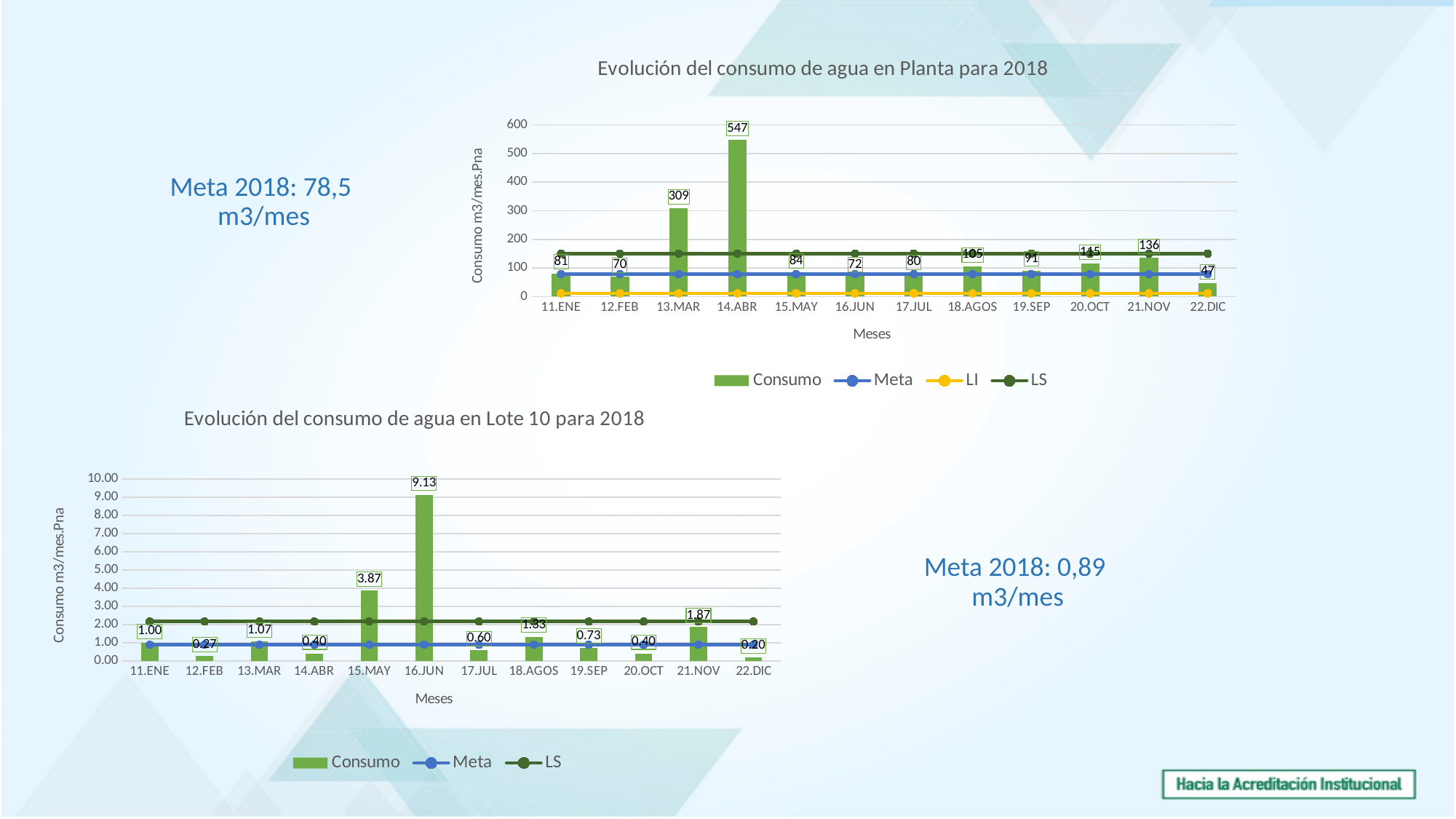
In the chart 'Evolución del consumo de agua en Planta para 2018', what is the difference between the Consumo values for 14.ABR and 13.MAR? 238 In the chart 'Evolución del consumo de agua en Planta para 2018', what is the Consumo value for 14.ABR? 547 In the chart 'Evolución del consumo de agua en Lote 10 para 2018', what is the difference between the Consumo values for 16.JUN and 15.MAY? 5.26 In the chart 'Evolución del consumo de agua en Planta para 2018', which month has the lowest Consumo? 22.DIC In the chart 'Evolución del consumo de agua en Planta para 2018', which month has the highest Consumo? 14.ABR In the chart 'Evolución del consumo de agua en Lote 10 para 2018', which month has the lowest Consumo? 22.DIC In the chart 'Evolución del consumo de agua en Lote 10 para 2018', what is the Consumo value for 16.JUN? 9.13 In the chart 'Evolución del consumo de agua en Lote 10 para 2018', which is larger, the Consumo for 15.MAY or for 21.NOV? 15.MAY What kind of chart is 'Evolución del consumo de agua en Lote 10 para 2018'? Bar chart with line series In the chart 'Evolución del consumo de agua en Planta para 2018', how many series does the legend list? 4 In the chart 'Evolución del consumo de agua en Planta para 2018', is the Consumo value for 13.MAR greater or less than 200? greater In the chart 'Evolución del consumo de agua en Lote 10 para 2018', how many months are shown on the x axis? 12